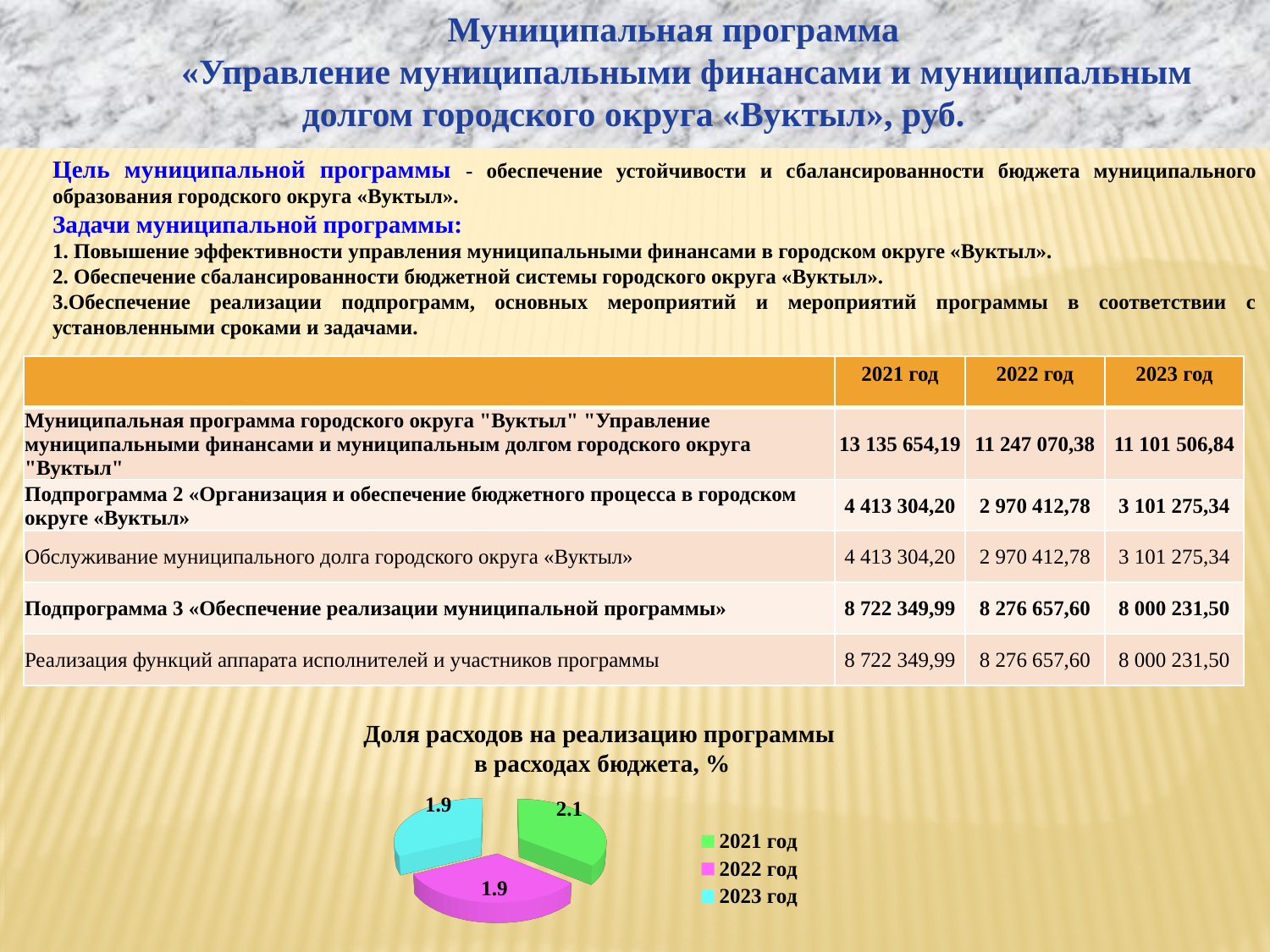
How many slices does the pie chart have? 3 What is the value for 2021 год in the pie chart? 2.1 What is the difference between the values for 2021 год and 2022 год in the pie chart? 0.2 Which is larger in the pie chart, the value for 2021 год or the value for 2023 год? 2021 год What is the value for 2023 год in the pie chart? 1.9 What is the value for 2022 год in the pie chart? 1.9 What is the title of the pie chart? Доля расходов на реализацию программы в расходах бюджета, % What kind of chart is shown at the bottom of the slide? Pie chart How many entries does the legend of the pie chart list? 3 What colour is the slice for 2021 год in the pie chart? Green Does the share of programme expenditure rise or fall from 2021 год to 2023 год? Fall Which year has the largest slice in the pie chart? 2021 год